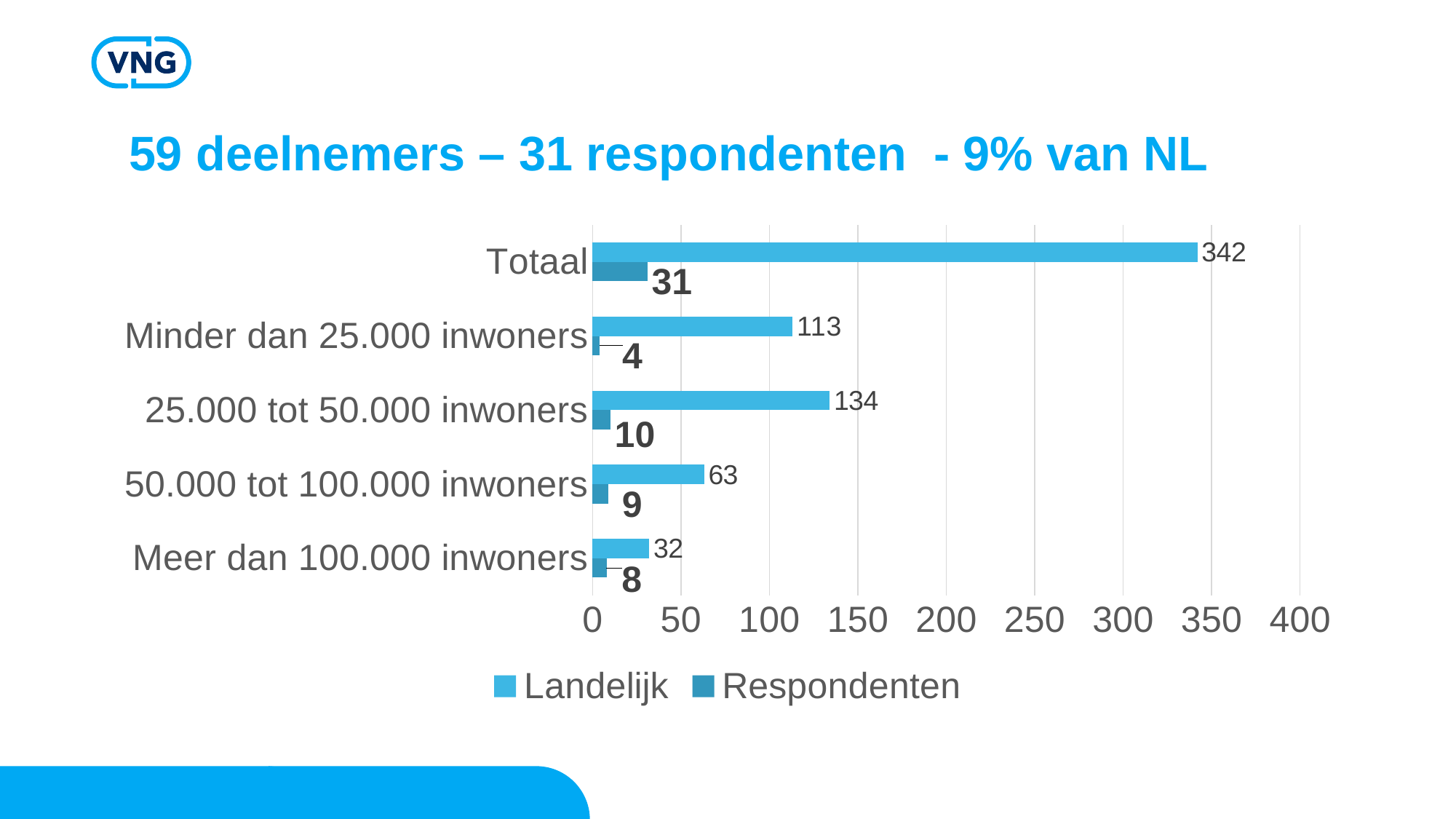
What are the two series named in the legend? Landelijk and Respondenten What is the Respondenten value for 25.000 tot 50.000 inwoners? 10 What is the difference between the Landelijk values for 25.000 tot 50.000 inwoners and Minder dan 25.000 inwoners? 21 How many categories are shown on the y axis? 5 What is the Respondenten value for Minder dan 25.000 inwoners? 4 What kind of chart is shown on the slide? Bar chart How many series does the legend list? 2 Which category has the lowest Respondenten value? Minder dan 25.000 inwoners What is the Landelijk value for Totaal? 342 Excluding Totaal, which category has the highest Landelijk value? 25.000 tot 50.000 inwoners What is the Landelijk value for Meer dan 100.000 inwoners? 32 Which is larger: the Respondenten value for 50.000 tot 100.000 inwoners or for Meer dan 100.000 inwoners? 50.000 tot 100.000 inwoners